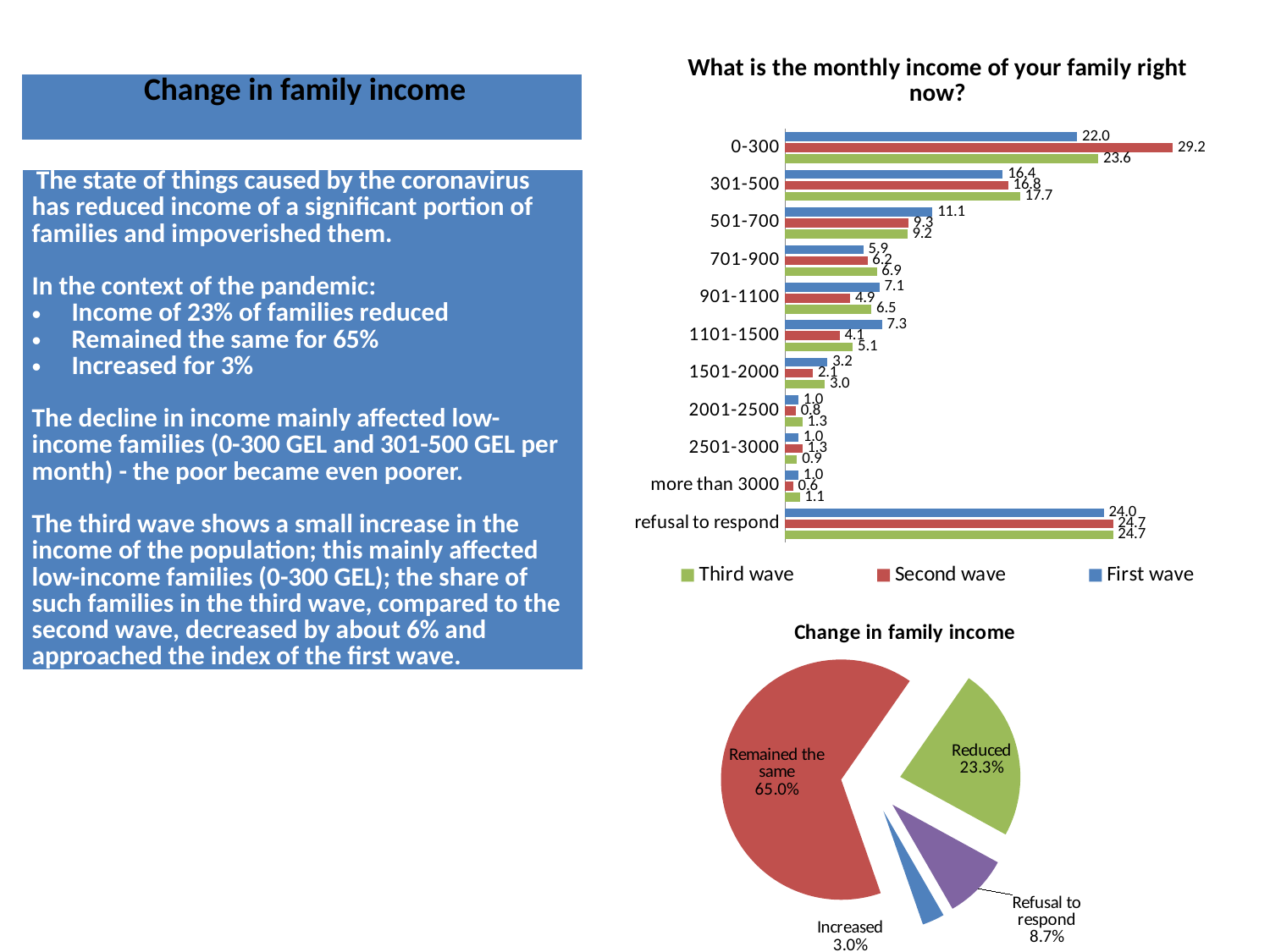
How many income categories are shown in the chart 'What is the monthly income of your family right now?'? 11 In the pie chart 'Change in family income', what share of families had their income reduced? 23.3% In the pie chart 'Change in family income', which category has the smallest slice? Increased What kind of chart is 'What is the monthly income of your family right now?'? Bar chart In the chart 'What is the monthly income of your family right now?', what is the First wave value for the 501-700 category? 11.1 In the chart 'What is the monthly income of your family right now?', what is the difference between the Second wave and Third wave values for 0-300? 5.6 In the chart 'What is the monthly income of your family right now?', which is larger for the 1101-1500 category: the First wave value or the Second wave value? First wave In the chart 'What is the monthly income of your family right now?', what is the Second wave value for the 0-300 category? 29.2 In the chart 'What is the monthly income of your family right now?', which income category has the highest Second wave value? 0-300 In the pie chart 'Change in family income', which category has the largest slice? Remained the same In the chart 'What is the monthly income of your family right now?', what is the Third wave value for 301-500? 17.7 How many series does the legend of the chart 'What is the monthly income of your family right now?' list? 3